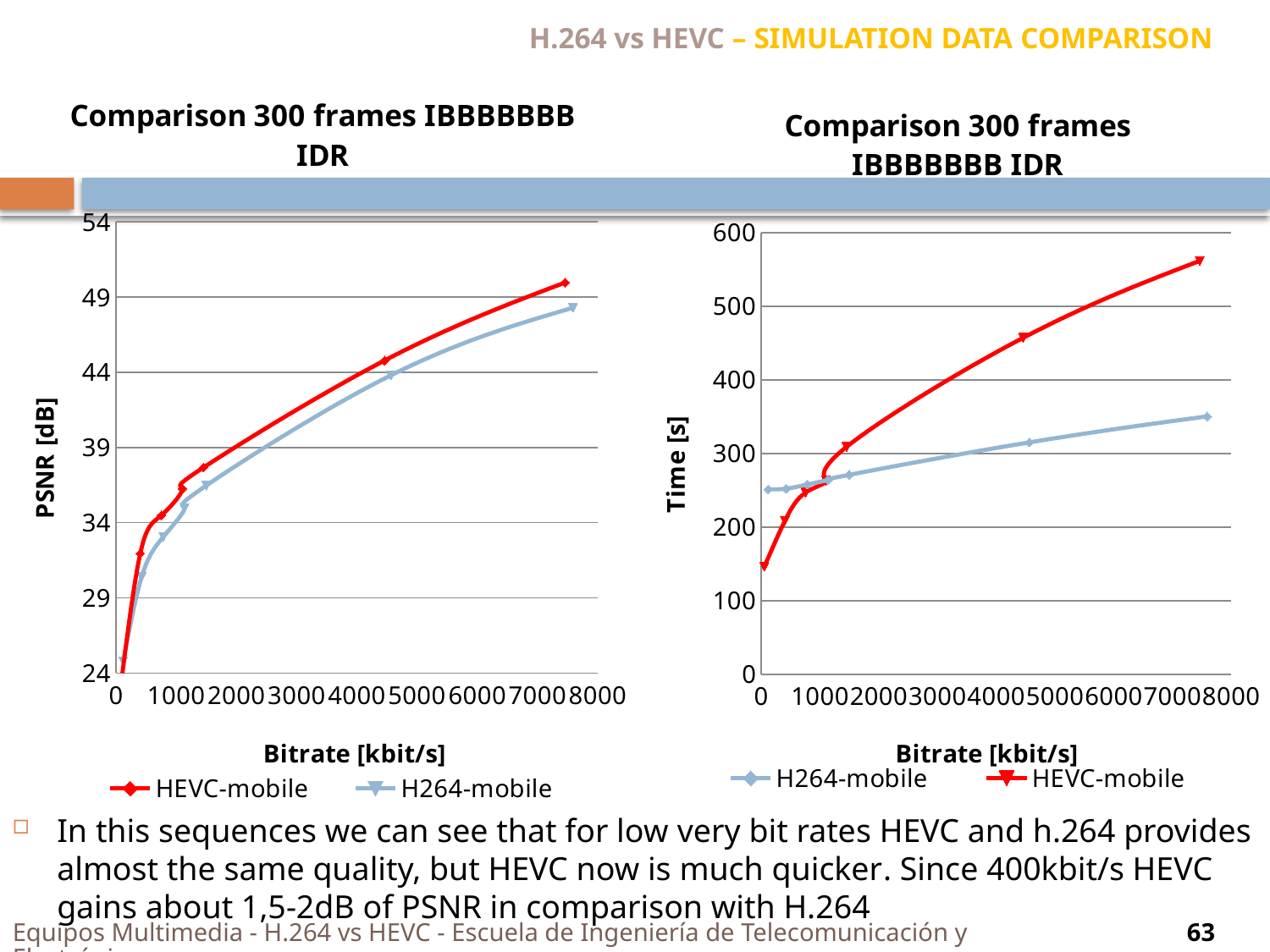
In the right chart (Time vs Bitrate), is the value for HEVC-mobile at the highest bitrate greater or less than 500? greater In the right chart (Time vs Bitrate), is the value for H264-mobile at the highest bitrate greater or less than 400? less How many series does the legend of the left chart list? 2 What is the y-axis title of the right chart? Time [s] What is the y-axis title of the left chart? PSNR [dB] In the right chart (Time vs Bitrate), does the HEVC-mobile time rise or fall as bitrate increases? rise In the left chart (PSNR vs Bitrate), which series has the higher PSNR at the highest bitrate, HEVC-mobile or H264-mobile? HEVC-mobile What kind of chart is the left chart (PSNR vs Bitrate)? line chart What kind of chart is the right chart (Time vs Bitrate)? line chart In the right chart (Time vs Bitrate), which series has the higher time at the highest bitrate, HEVC-mobile or H264-mobile? HEVC-mobile How many series does the legend of the right chart list? 2 In the left chart (PSNR vs Bitrate), is the value for H264-mobile at the highest bitrate greater or less than 49? less